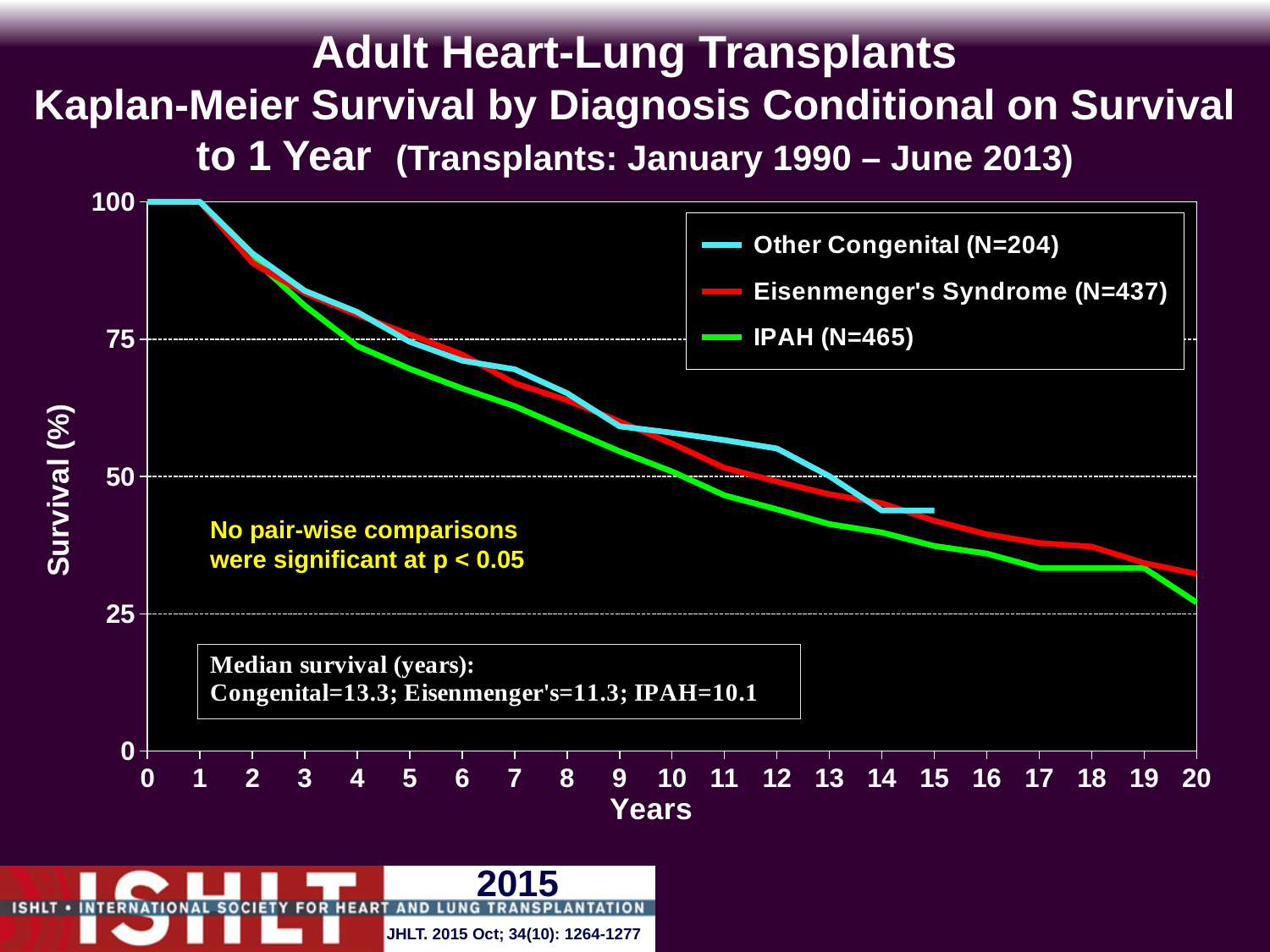
Is the survival value for Eisenmenger's Syndrome at year 20 greater or less than 25? greater Which diagnosis group has the lowest survival at year 12? IPAH Is the survival value for IPAH at year 12 greater or less than 50? less Is the survival value for Other Congenital at year 4 greater or less than 75? greater What is the median survival in years for IPAH as stated on the slide? 10.1 At year 12, which has higher survival: Other Congenital or IPAH? Other Congenital Do the survival curves rise or fall as years increase along the x axis? fall What is the survival percentage for all three diagnosis groups at year 0? 100 What kind of chart is shown on the slide? line chart How many series does the legend list? 3 What is the number of patients (N) in the IPAH group according to the legend? 465